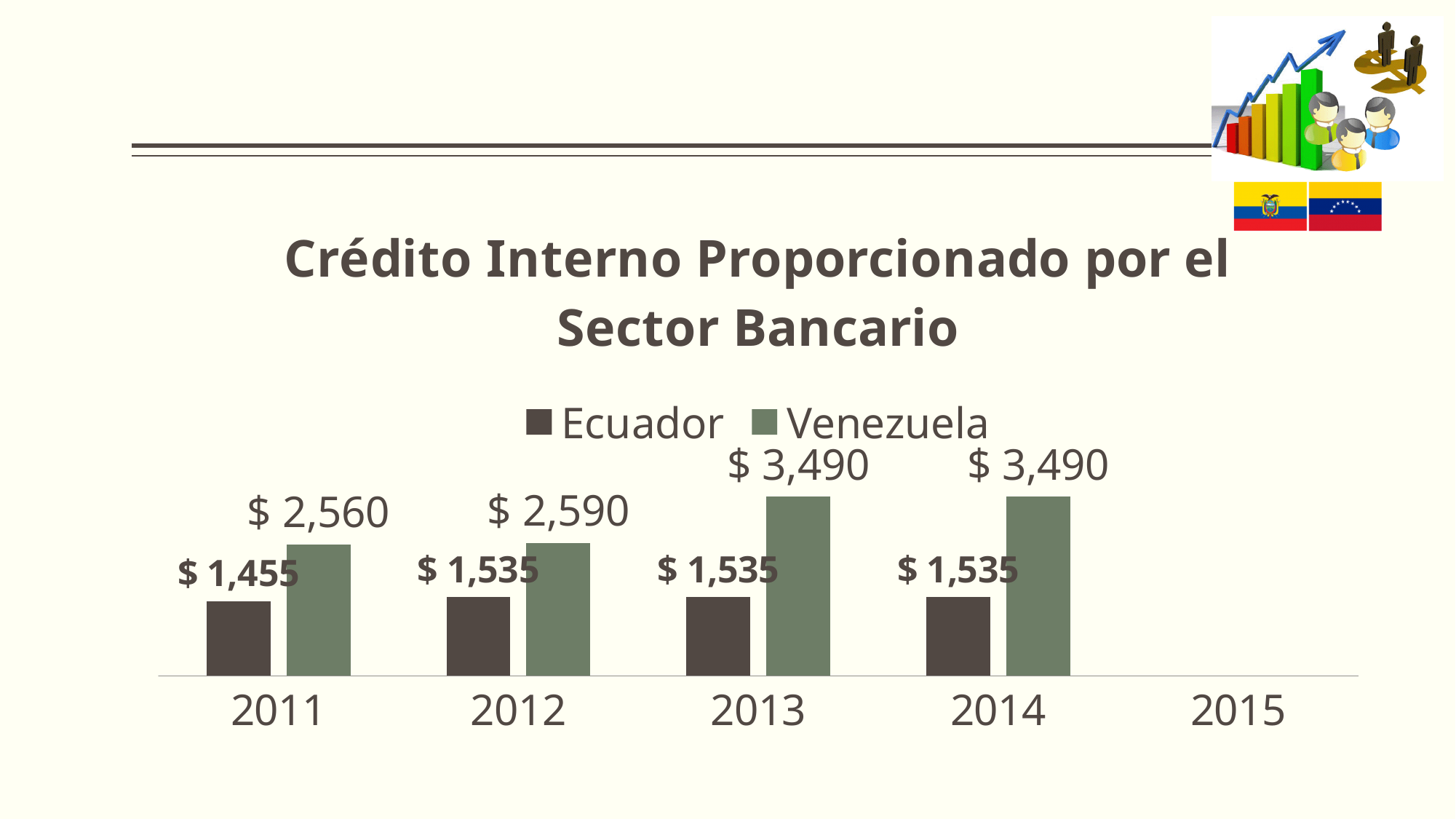
How many series does the legend list? 2 Which is larger in 2013, the Ecuador value or the Venezuela value? Venezuela What is the difference between the Venezuela and Ecuador values in 2011? $ 1,105 What is the value for Ecuador in 2011? $ 1,455 What is the value for Ecuador in 2014? $ 1,535 In which year is the Venezuela value lowest? 2011 What is the title of the chart? Crédito Interno Proporcionado por el Sector Bancario What is the value for Venezuela in 2013? $ 3,490 In which year is the Ecuador value lowest? 2011 What is the value for Venezuela in 2012? $ 2,590 What is the difference between the Venezuela values in 2013 and 2012? $ 900 What kind of chart is shown on the slide? Bar chart